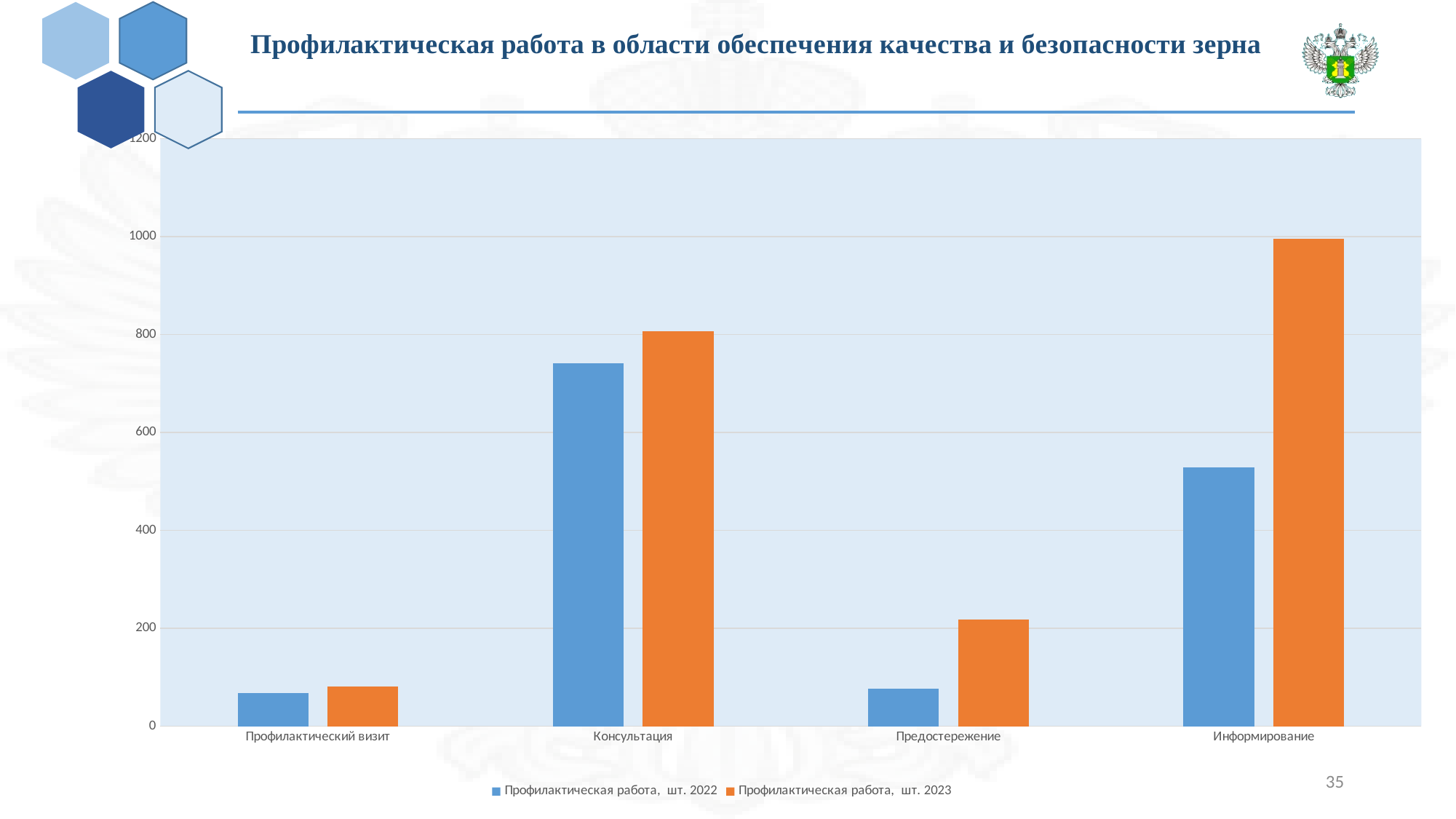
What kind of chart is shown on the slide? bar chart Is the 2023 value for Информирование greater or less than 800? greater Is the 2022 value for Консультация greater or less than 600? greater How many categories are shown on the x axis of the chart? 4 How many series does the chart legend list? 2 Is the 2022 value for Информирование greater or less than 400? greater Which category has the highest value for the series 'Профилактическая работа, шт. 2023'? Информирование For the 2022 series, which is larger: Консультация or Информирование? Консультация Which category has the highest value for the series 'Профилактическая работа, шт. 2022'? Консультация Which category has the lowest value for the series 'Профилактическая работа, шт. 2023'? Профилактический визит Which colour represents the series 'Профилактическая работа, шт. 2023' in the chart? orange